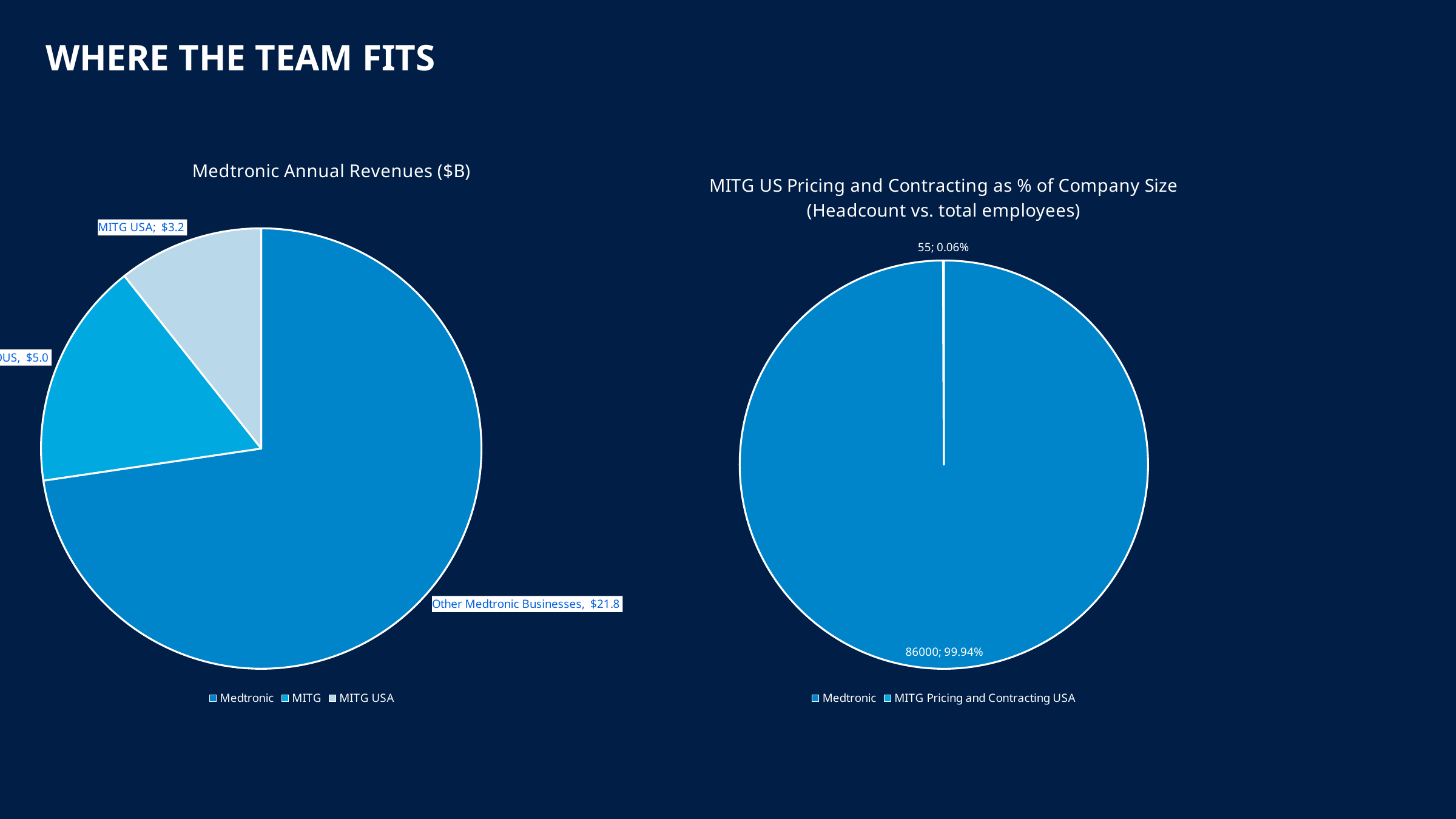
In the 'MITG US Pricing and Contracting as % of Company Size' chart, what share of the pie does MITG Pricing and Contracting USA represent? 0.06% In the 'Medtronic Annual Revenues ($B)' chart, what is the difference between Other Medtronic Businesses and MITG USA? $18.6 In the 'MITG US Pricing and Contracting as % of Company Size' chart, what is the value for Medtronic? 86000 In the 'Medtronic Annual Revenues ($B)' chart, which slice is the largest? Other Medtronic Businesses In the 'MITG US Pricing and Contracting as % of Company Size' chart, what is the headcount for MITG Pricing and Contracting USA? 55 In the 'MITG US Pricing and Contracting as % of Company Size' chart, how many entries does the legend list? 2 In the 'MITG US Pricing and Contracting as % of Company Size' chart, what share of the pie does Medtronic represent? 99.94% In the 'Medtronic Annual Revenues ($B)' chart, how many entries does the legend list? 3 In the 'Medtronic Annual Revenues ($B)' chart, what is the value for Other Medtronic Businesses? $21.8 In the 'Medtronic Annual Revenues ($B)' chart, what is the value for MITG USA? $3.2 What kind of chart is the 'Medtronic Annual Revenues ($B)' chart? pie chart In the 'Medtronic Annual Revenues ($B)' chart, how many slices does the pie have? 3